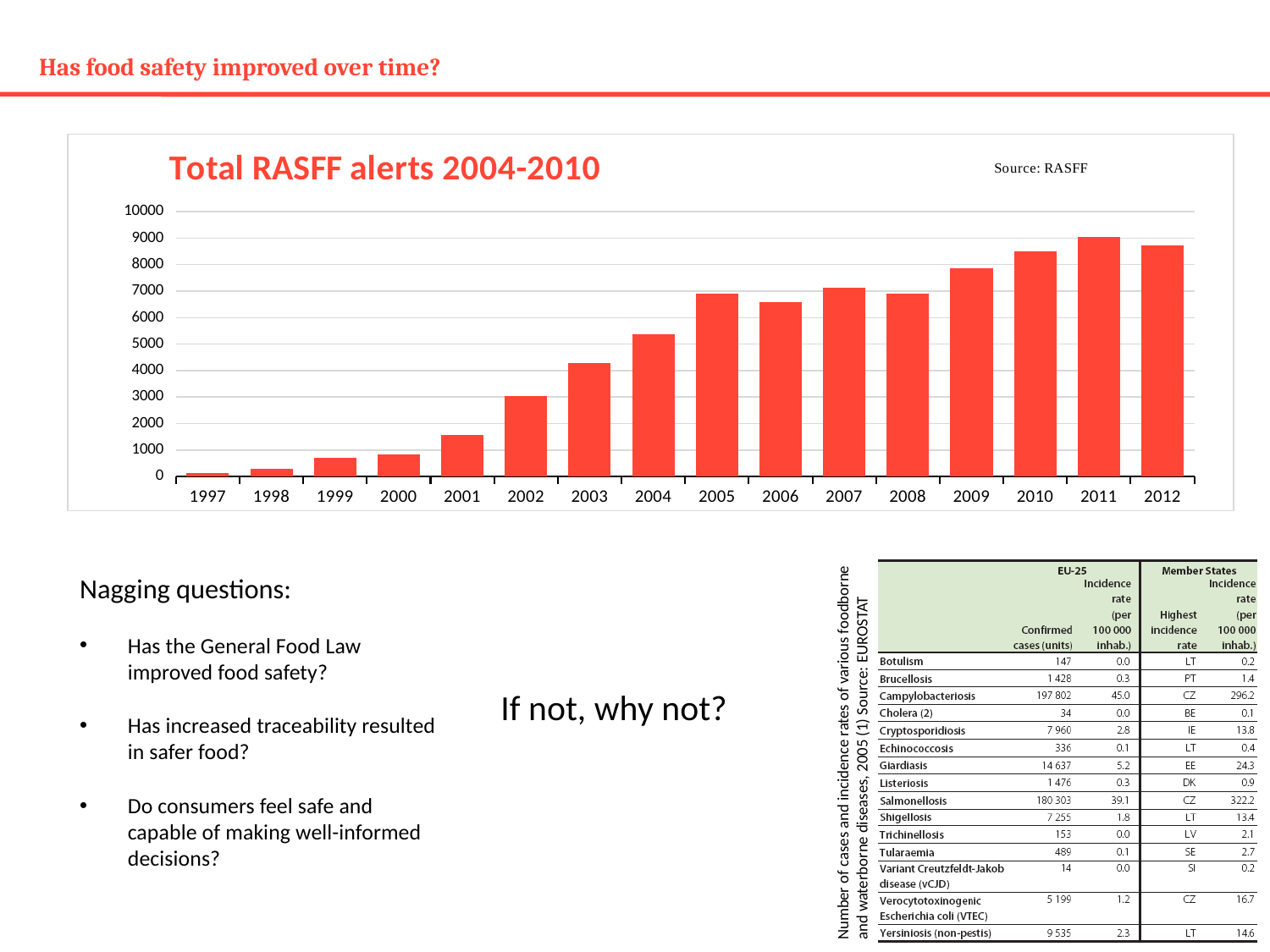
Which year has the highest number of RASFF alerts? 2011 What source is cited for the chart? RASFF How many years are shown on the x axis of the chart? 16 Is the value for 2003 greater or less than 4000? greater Which year has the lowest number of RASFF alerts? 1997 What kind of chart is shown on the slide? bar chart Is the value for 2010 greater or less than 8000? greater What is the title of the chart? Total RASFF alerts 2004-2010 Is the value for 2001 greater or less than 1000? greater Which year has more RASFF alerts, 2005 or 2006? 2005 Do the values generally rise or fall from 1997 to 2012? rise